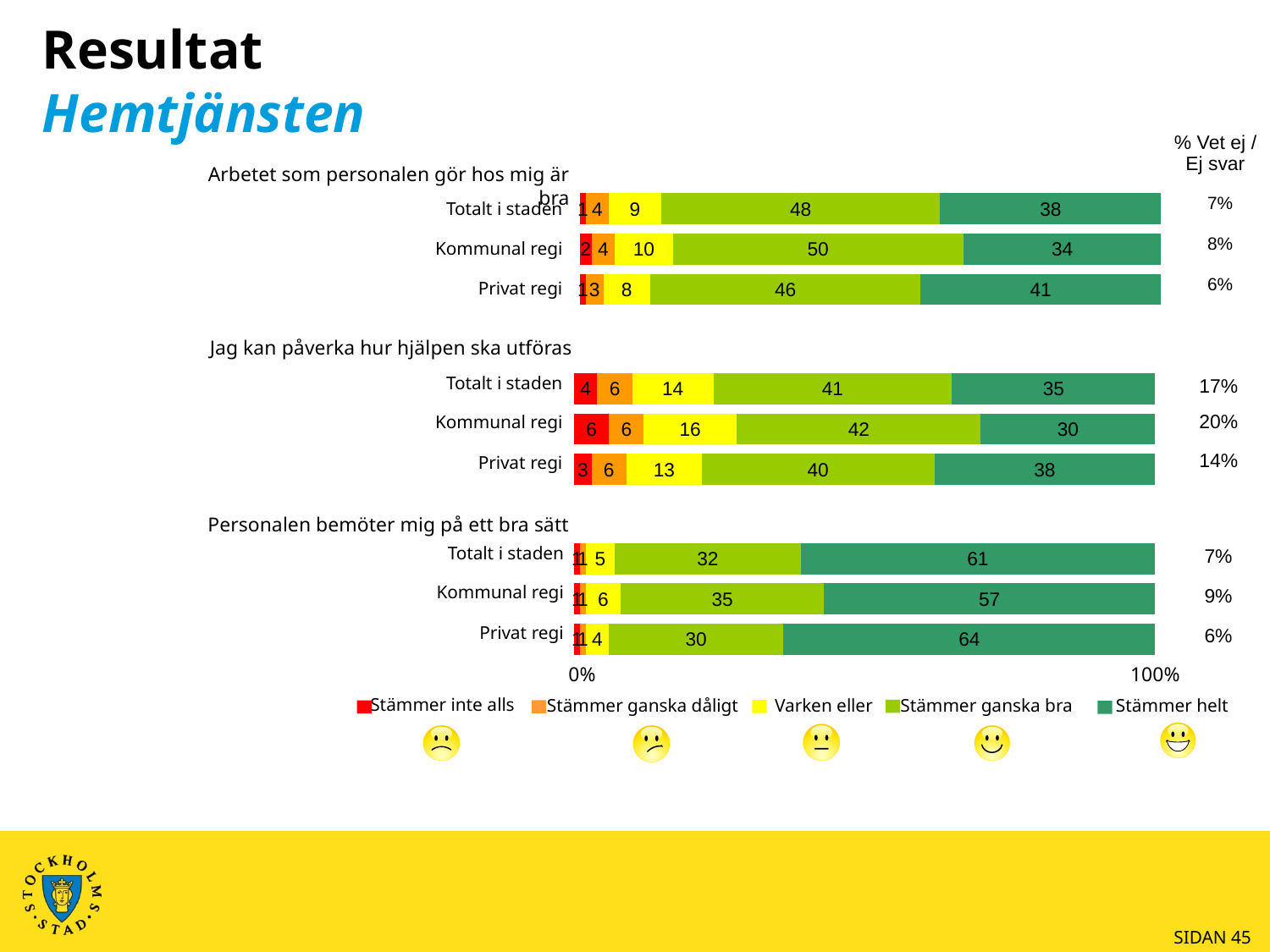
What is the '% Vet ej / Ej svar' value for Kommunal regi in the chart 'Jag kan påverka hur hjälpen ska utföras'? 20% What kind of chart is used on this slide? Stacked bar chart In the chart 'Jag kan påverka hur hjälpen ska utföras', what is the 'Varken eller' value for Kommunal regi? 16 In the chart 'Personalen bemöter mig på ett bra sätt', which category has the highest 'Stämmer helt' value? Privat regi In the chart 'Jag kan påverka hur hjälpen ska utföras', is the 'Stämmer helt' value larger for Totalt i staden or for Privat regi? Privat regi How many series does the legend list? 5 In the chart 'Arbetet som personalen gör hos mig är bra', what is the difference between the 'Stämmer ganska bra' values for Kommunal regi and Privat regi? 4 How many categories (bars) are shown in the chart 'Personalen bemöter mig på ett bra sätt'? 3 In the chart 'Personalen bemöter mig på ett bra sätt', what is the 'Stämmer ganska bra' value for Totalt i staden? 32 In the chart 'Jag kan påverka hur hjälpen ska utföras', what is the total of the stacked bar for Kommunal regi? 100 In the chart 'Arbetet som personalen gör hos mig är bra', what is the 'Stämmer helt' value for Privat regi? 41 In the chart 'Jag kan påverka hur hjälpen ska utföras', which category has the lowest 'Stämmer helt' value? Kommunal regi